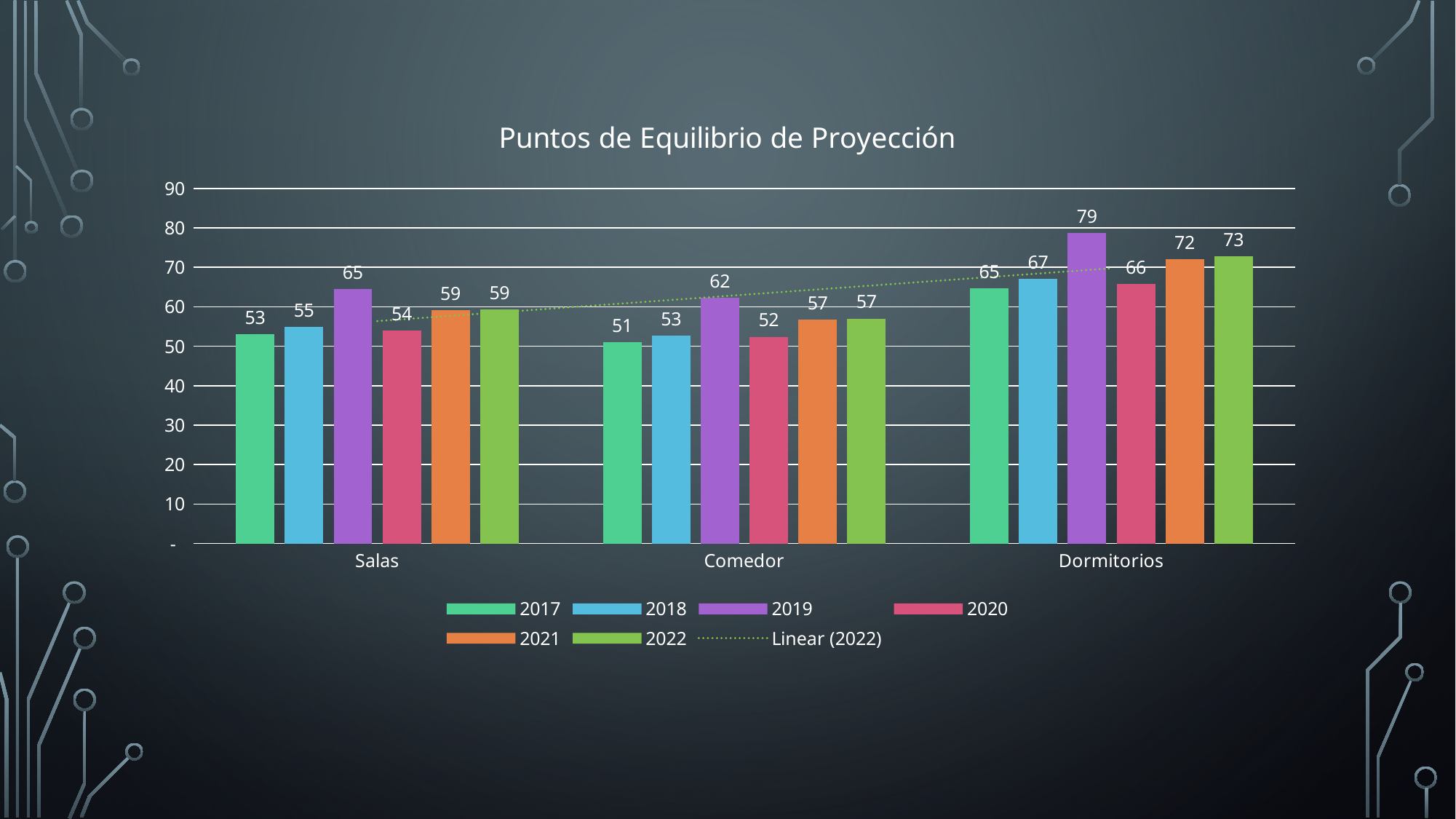
What is the difference between the 2022 value and the 2021 value in the Dormitorios category? 1 What is the value for 2017 in the Comedor category? 51 Which category has the highest value for the 2022 series? Dormitorios How many entries does the legend list? 7 Which category has the lowest value for the 2018 series? Comedor What is the value for 2021 in the Salas category? 59 What kind of chart is shown on the slide? Bar chart What is the title of the chart? Puntos de Equilibrio de Proyección How many categories are shown on the x axis? 3 What is the value for 2019 in the Dormitorios category? 79 Which is larger: the 2020 value for Salas or the 2020 value for Comedor? Salas What is the difference between the 2019 value and the 2017 value in the Dormitorios category? 14